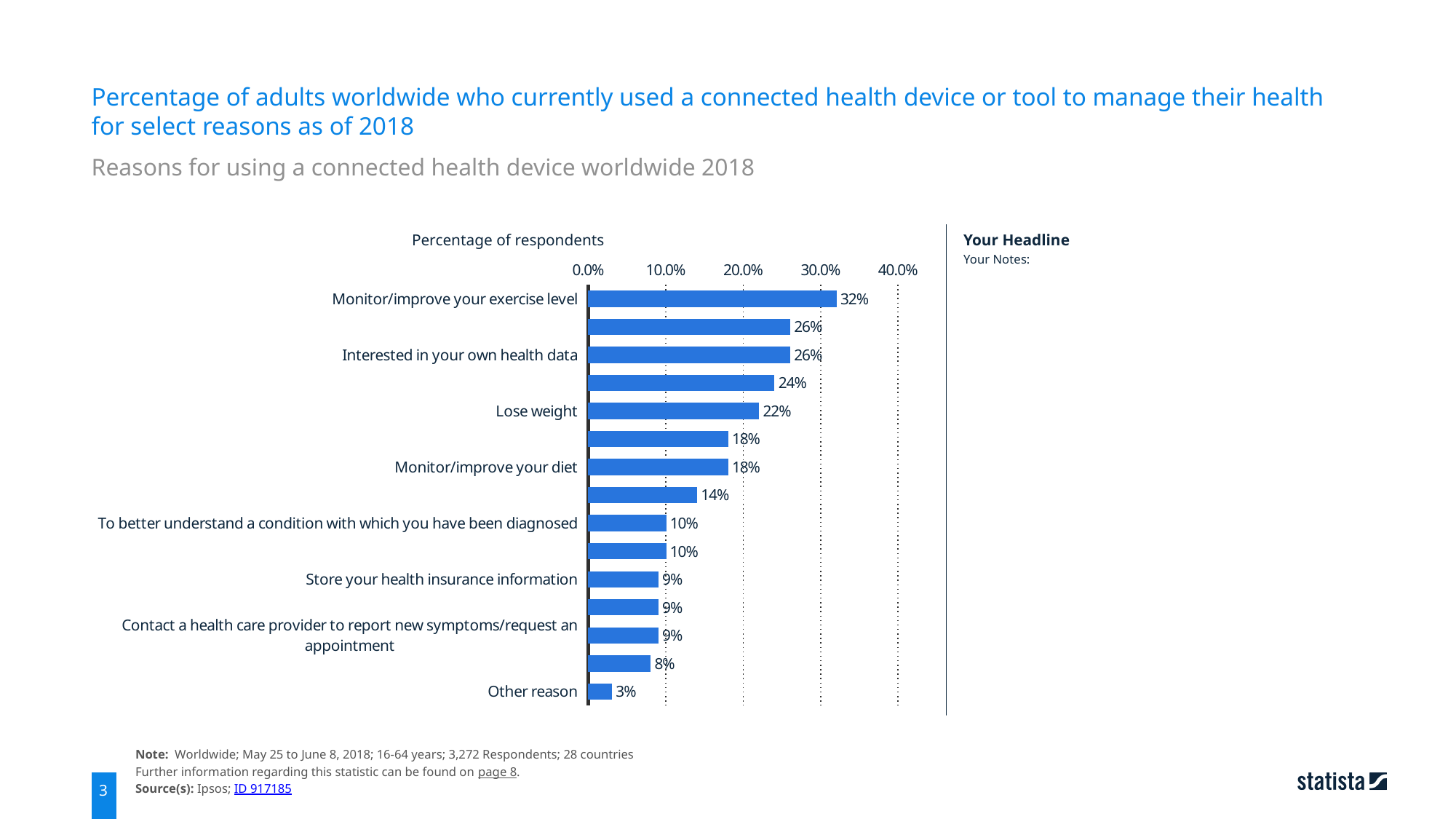
Which is larger: the value for 'Interested in your own health data' or the value for 'Monitor/improve your diet'? Interested in your own health data Which labelled reason has the highest percentage of respondents? Monitor/improve your exercise level What is the value for 'Interested in your own health data'? 26% How many bars are plotted in the chart? 15 What percentage of respondents used a connected health device to monitor/improve their exercise level? 32% What percentage of respondents used a device to better understand a condition with which they have been diagnosed? 10% Which reason has the lowest percentage of respondents? Other reason What is the difference between the values for 'Monitor/improve your exercise level' and 'Lose weight'? 10% What kind of chart is shown on the slide? Bar chart What is the value for 'Other reason'? 3% What percentage of respondents cited 'Lose weight' as a reason? 22% What is the value for 'Monitor/improve your diet'? 18%